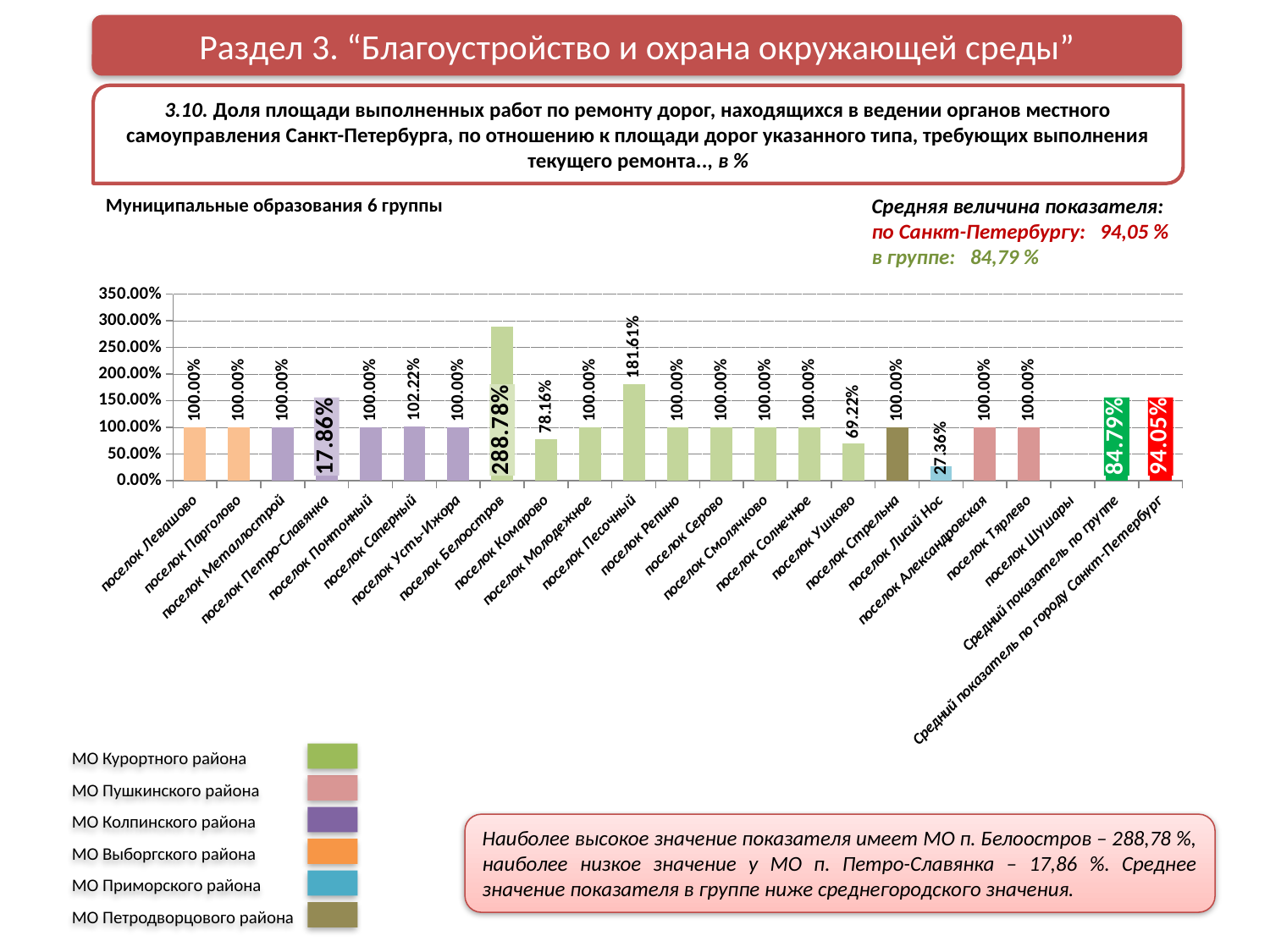
How many district groups does the legend list? 6 What is the value for поселок Лисий Нос? 27.36% Which is larger, the value for поселок Комарово or поселок Ушково? поселок Комарово What is the value for поселок Белоостров? 288.78% Which category has the highest value? поселок Белоостров What is the difference between the values for поселок Белоостров and поселок Песочный? 107.17 percentage points Is the value for поселок Песочный greater or less than 150.00%? greater Which category has the lowest labelled value? поселок Петро-Славянка What kind of chart is shown on the slide? bar chart What is the value for поселок Песочный? 181.61% What is the value for поселок Саперный? 102.22% What is the value shown for Средний показатель по группе? 84.79%